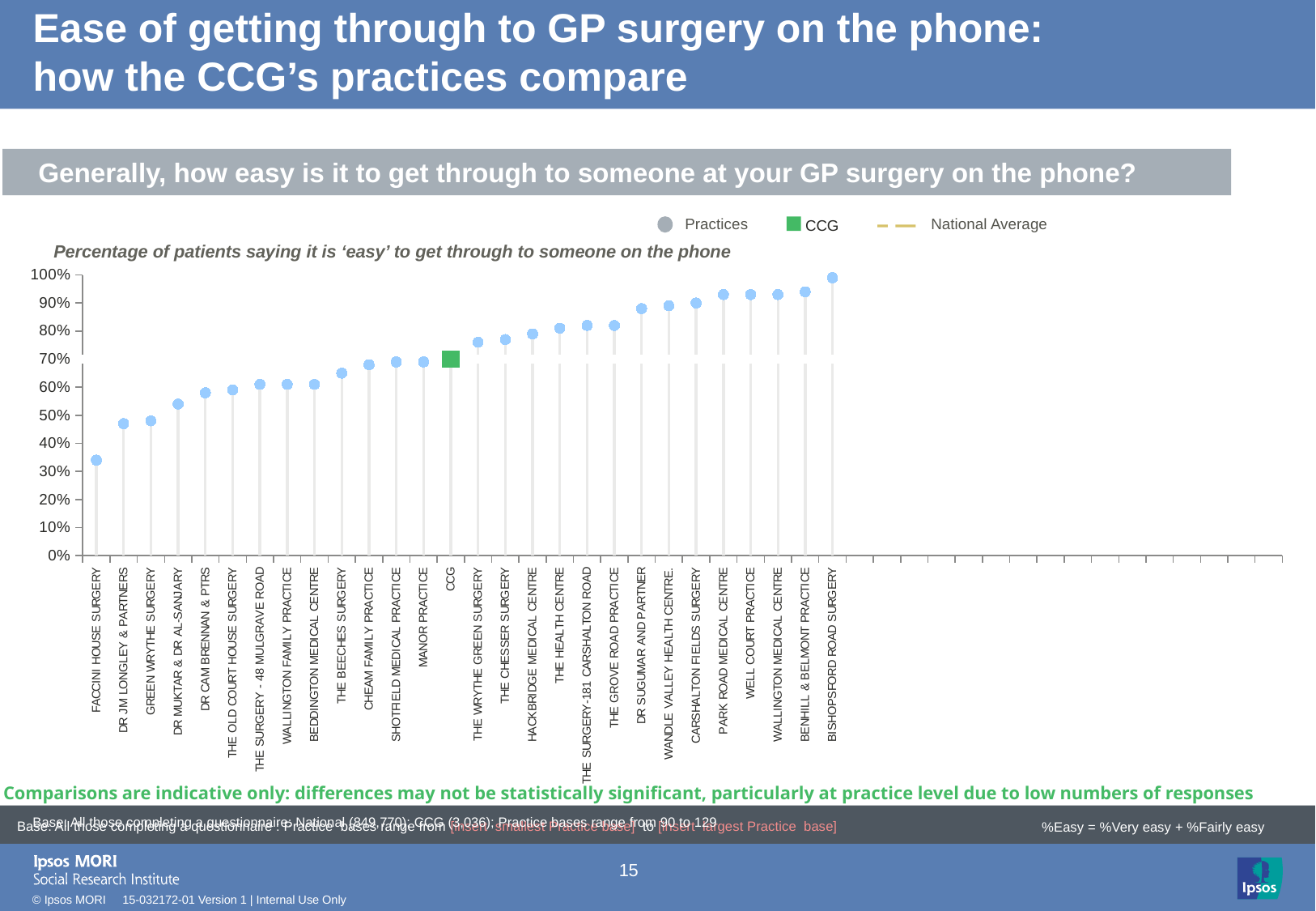
Which practice has the highest percentage of patients saying it is easy to get through on the phone? BISHOPSFORD ROAD SURGERY What colour is the marker used for the CCG in the chart? Green Which practice has the lowest percentage of patients saying it is easy to get through on the phone? FACCINI HOUSE SURGERY Is the value for PARK ROAD MEDICAL CENTRE greater or less than 80%? greater Do the values rise or fall moving from left to right along the x axis? rise What kind of chart is shown on the slide? Dot (lollipop) chart Is the value for FACCINI HOUSE SURGERY greater or less than 40%? less Which has a higher value, MANOR PRACTICE or GREEN WRYTHE SURGERY? MANOR PRACTICE How many series does the legend list? 3 Is the value for DR JM LONGLEY & PARTNERS greater or less than 50%? less